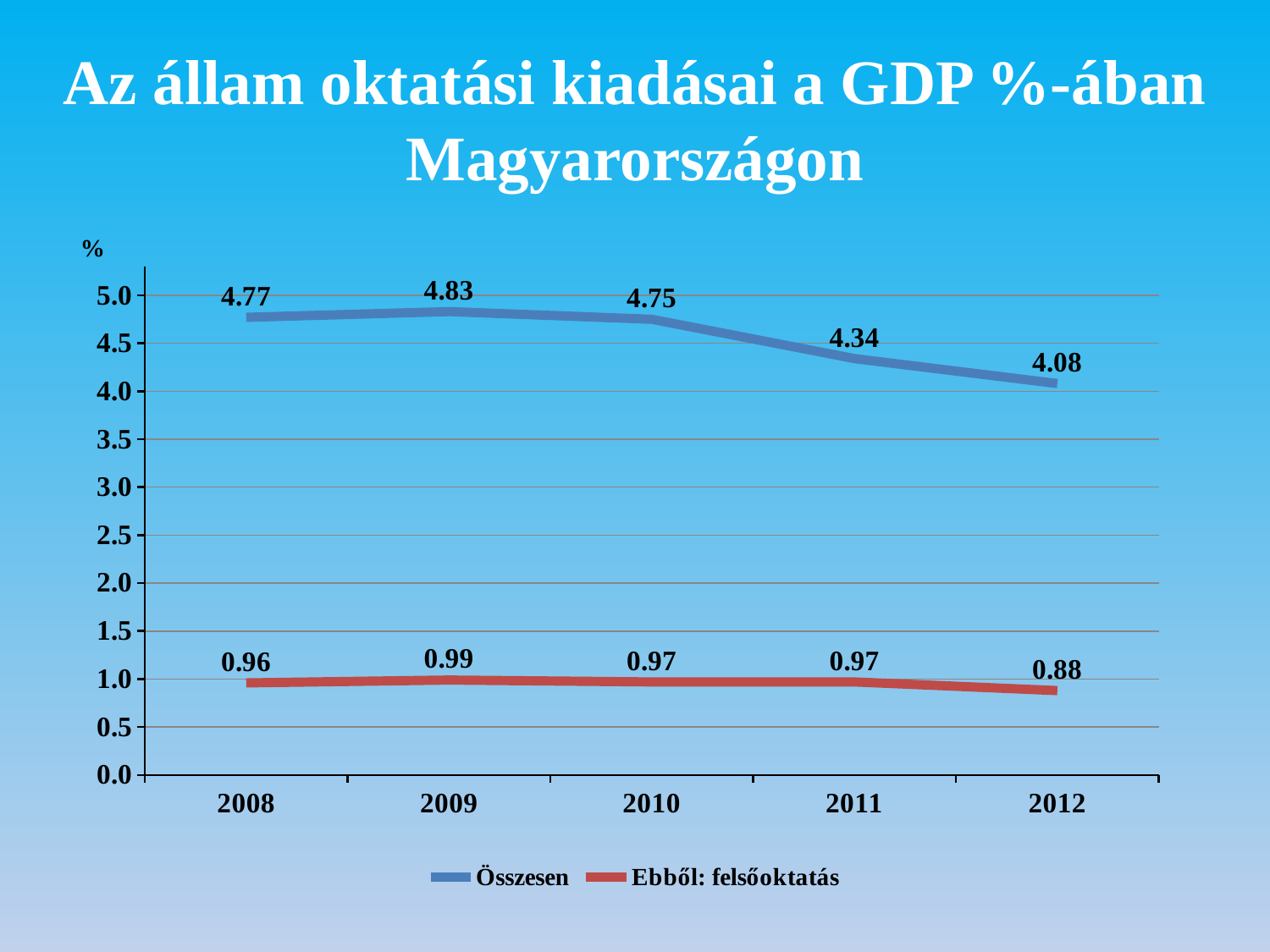
What is the value for Ebből: felsőoktatás in 2012? 0.88 What colour is the line for Ebből: felsőoktatás? red What is the difference between the Összesen values for 2008 and 2012? 0.69 What kind of chart is shown on the slide? line chart Which is larger, the Összesen value in 2010 or in 2011? 2010 Is the Összesen value for 2012 greater or less than 4.5? less In which year is the Összesen value highest? 2009 How many series does the legend list? 2 What is the value for Összesen in 2009? 4.83 How many years are shown on the x axis? 5 In which year is the Ebből: felsőoktatás value lowest? 2012 Does the Összesen series rise or fall from 2010 to 2012? fall